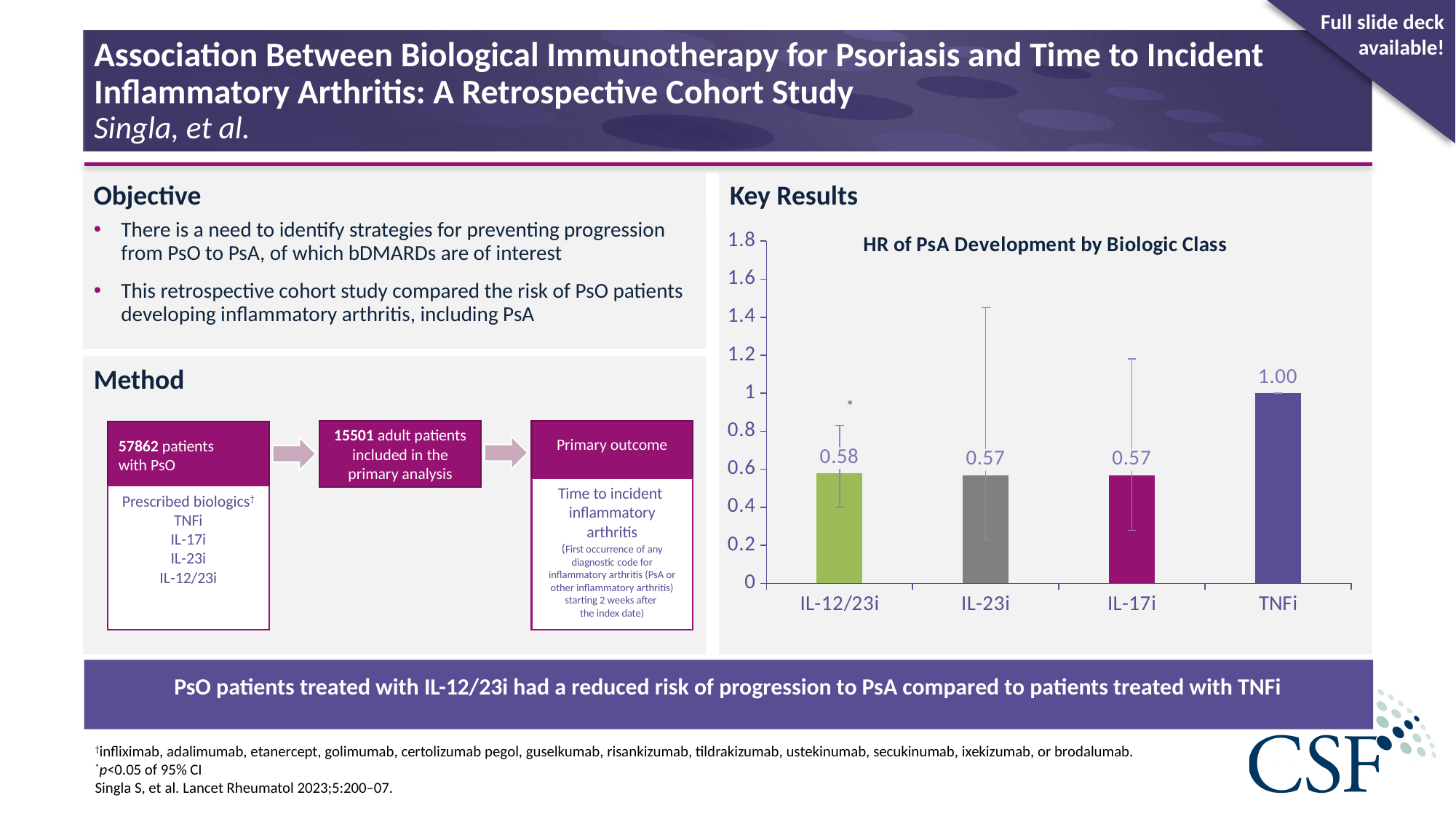
Which biologic class has the highest HR in the chart? TNFi Is the HR value for IL-17i greater or less than 0.8? less What is the title of the chart? HR of PsA Development by Biologic Class What is the HR value for IL-12/23i in the chart? 0.58 What is the highest value shown on the y axis of the chart? 1.8 What colour is the bar for IL-12/23i? green What kind of chart is shown under Key Results? bar chart How many biologic classes are shown on the x axis of the chart? 4 Which has a larger HR, TNFi or IL-17i? TNFi What is the difference between the HR for TNFi and the HR for IL-12/23i? 0.42 What is the HR value for TNFi in the chart? 1.00 What is the HR value for IL-23i in the chart? 0.57